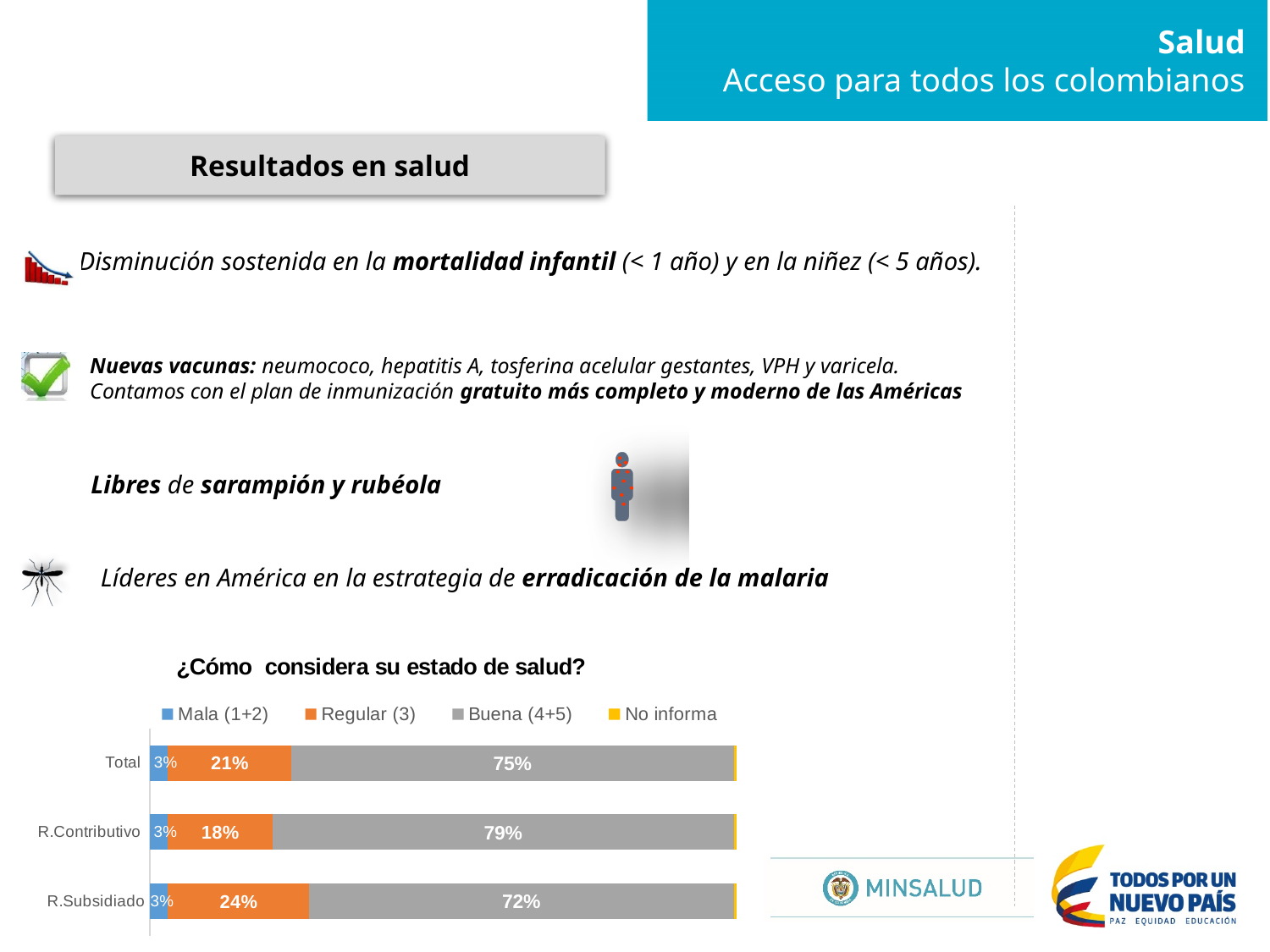
Which category has the highest "Buena (4+5)" value? R.Contributivo What is the "Mala (1+2)" value for R.Subsidiado? 3% What is the "Buena (4+5)" value for Total? 75% What is the difference between the "Buena (4+5)" values for R.Contributivo and R.Subsidiado? 7% What is the title of the chart? ¿Cómo considera su estado de salud? How many categories are shown on the y axis of the chart? 3 Which is larger, the "Regular (3)" value for R.Subsidiado or for Total? R.Subsidiado What type of chart is shown under the title "¿Cómo considera su estado de salud?"? Stacked bar chart What is the "Buena (4+5)" value for R.Subsidiado? 72% What is the "Regular (3)" value for R.Contributivo? 18% Which category has the lowest "Regular (3)" value? R.Contributivo How many series does the chart legend list? 4